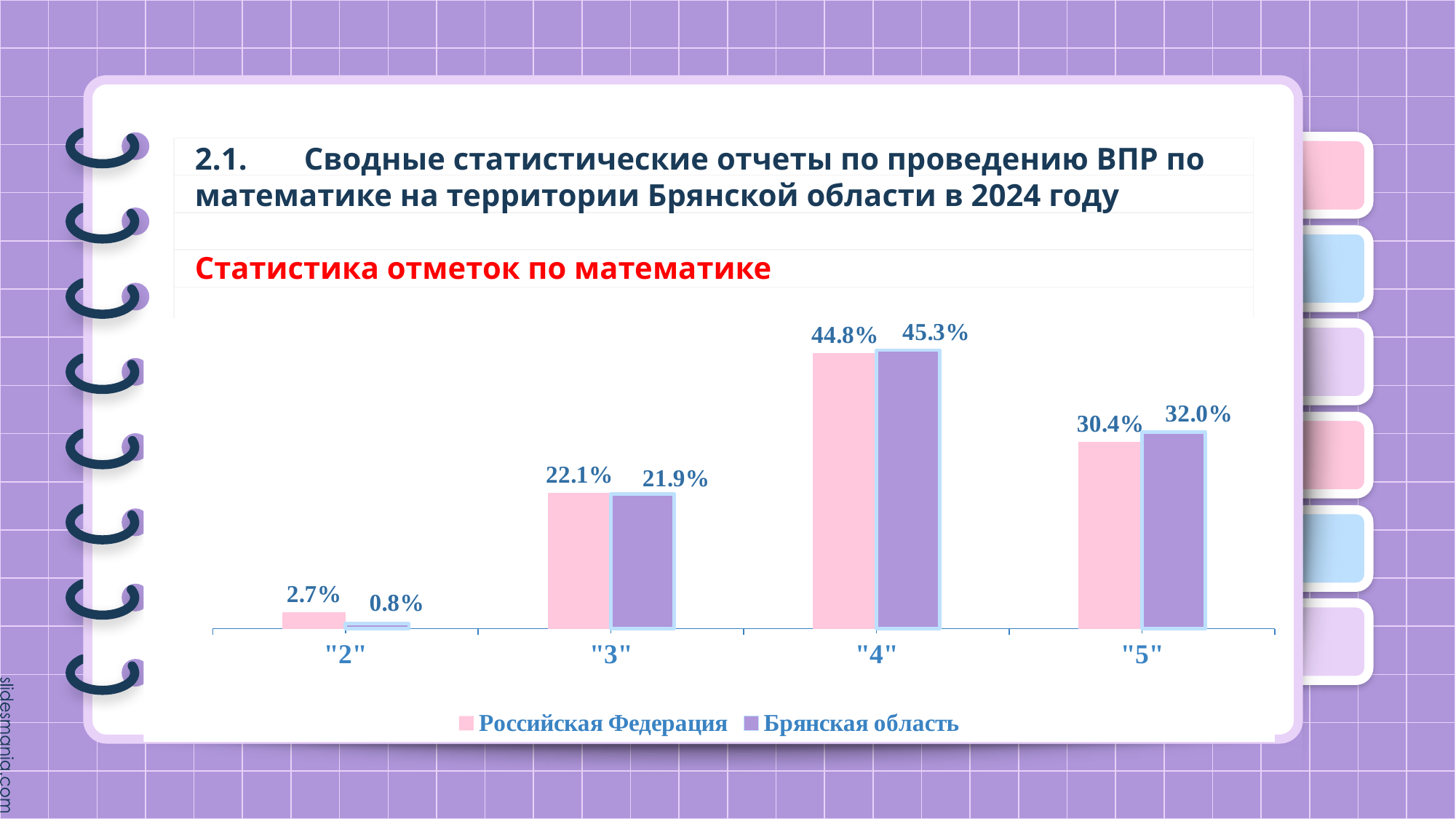
What kind of chart is shown on the slide? Bar chart Which grade category has the lowest value in the Российская Федерация series? "2" For "3", which series has the larger value: Российская Федерация or Брянская область? Российская Федерация What is the value for "5" in the Брянская область series? 32.0% What is the difference between the Российская Федерация and Брянская область values for "2"? 1.9% How many series does the legend list? 2 What is the difference between the Брянская область and Российская Федерация values for "5"? 1.6% How many grade categories are shown on the x axis? 4 What is the value for "4" in the Российская Федерация series? 44.8% Which grade category has the highest value in the Брянская область series? "4" What is the value for "2" in the Брянская область series? 0.8% Which colour represents the Брянская область series? Purple